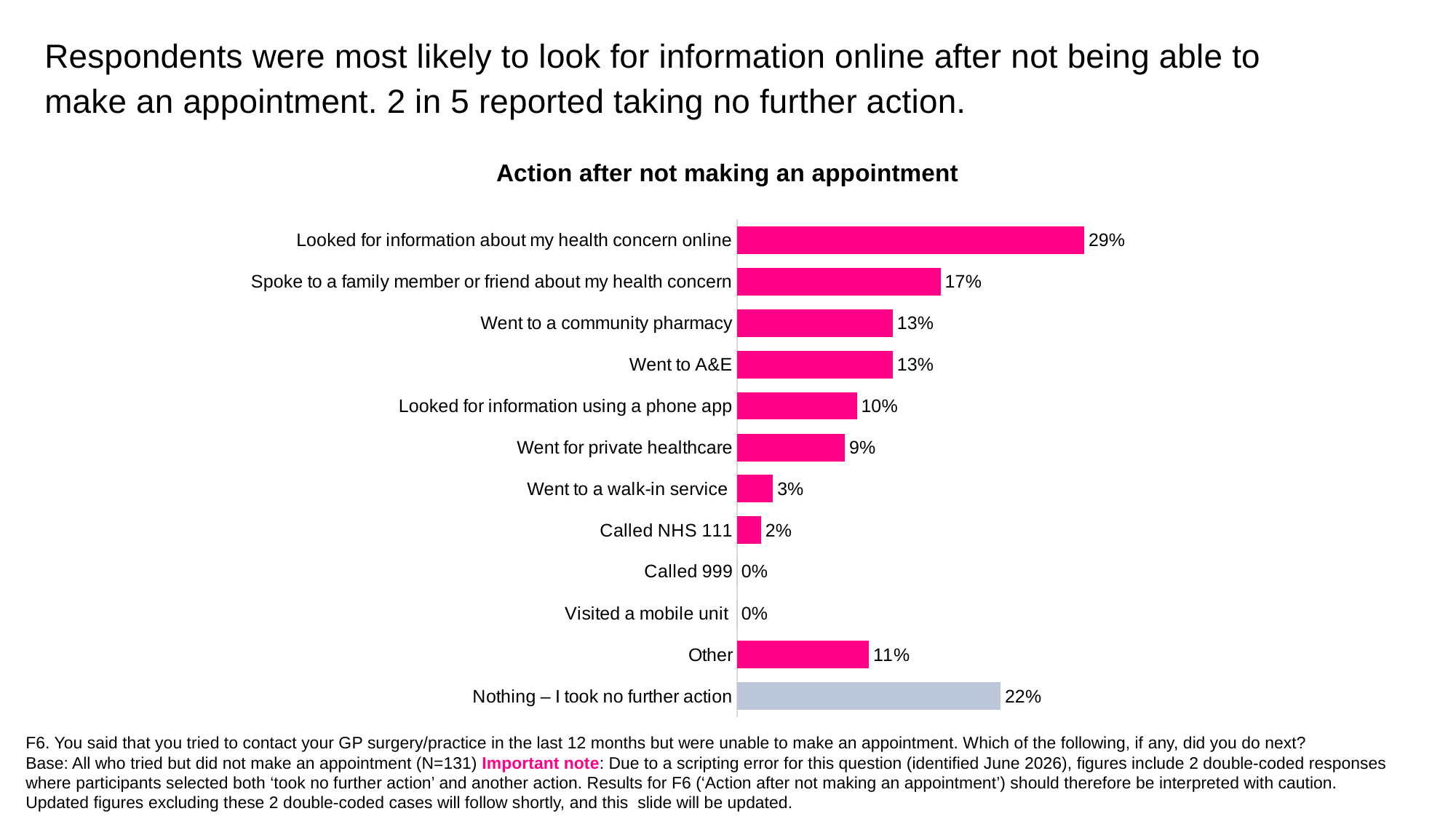
Which action has the highest percentage in the chart? Looked for information about my health concern online What percentage of respondents went to a community pharmacy? 13% How many categories are shown in the chart? 12 What percentage of respondents looked for information about their health concern online? 29% What kind of chart is shown on the slide? Bar chart What percentage of respondents reported taking no further action? 22% What percentage of respondents called NHS 111? 2% Which two categories have a value of 0%? Called 999 and Visited a mobile unit What is the title of the chart? Action after not making an appointment Which is larger: the percentage who went for private healthcare or the percentage who looked for information using a phone app? Looked for information using a phone app What is the difference in percentage points between 'Looked for information about my health concern online' and 'Spoke to a family member or friend about my health concern'? 12 Which bar is coloured differently (grey) from the others? Nothing – I took no further action